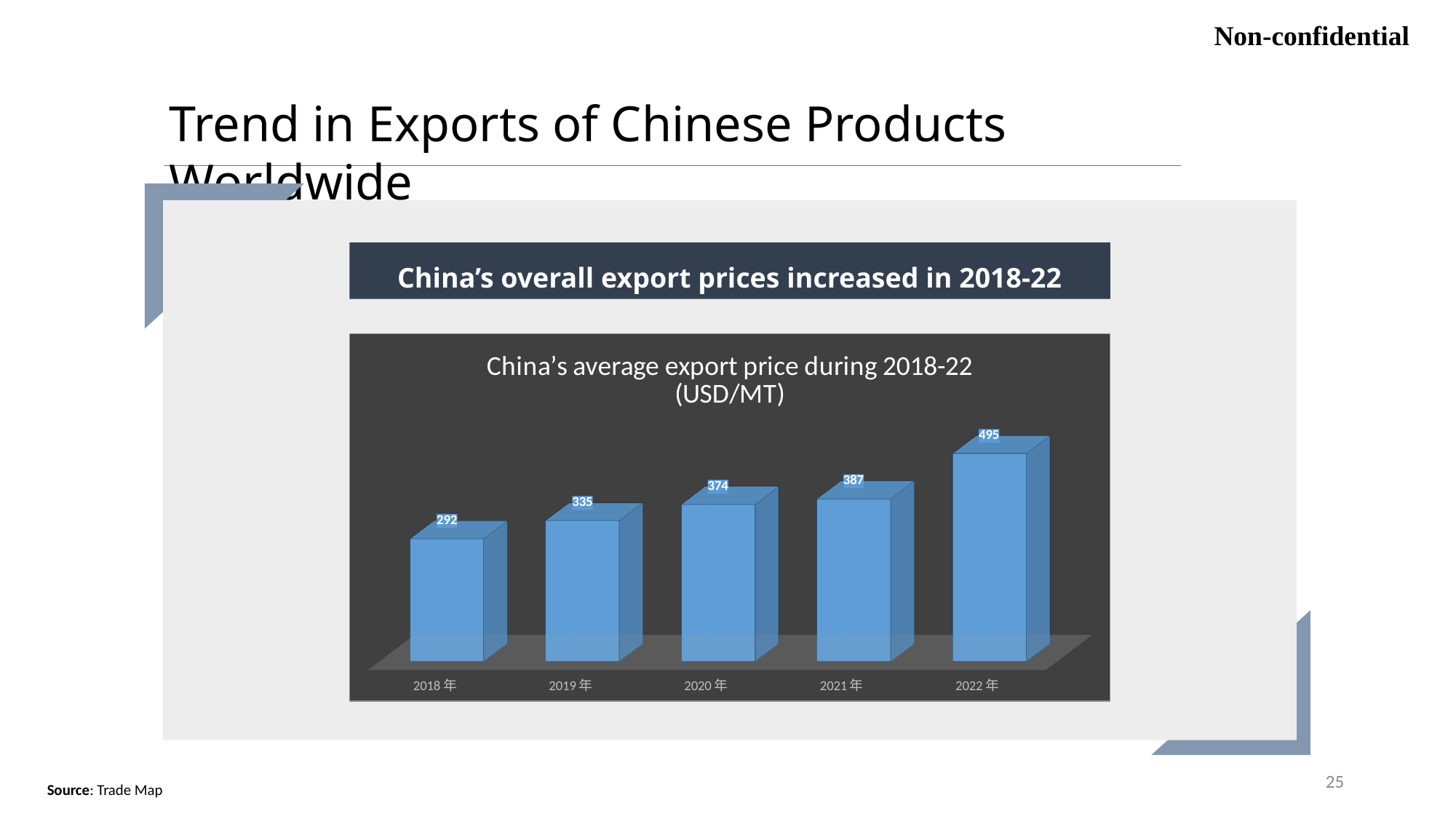
What kind of chart is shown on the slide? Bar chart What unit is the average export price given in, according to the chart title? USD/MT What was China's average export price in 2018? 292 Which year had a higher average export price, 2019 or 2021? 2021 What is the difference between the average export price in 2022 and in 2018? 203 Do the average export prices rise or fall from 2018 to 2022? Rise What was China's average export price in 2022? 495 Which year has the highest average export price? 2022 How many years are shown in the chart? 5 What is the difference between the average export price in 2021 and in 2020? 13 Which year has the lowest average export price? 2018 What was China's average export price in 2020? 374